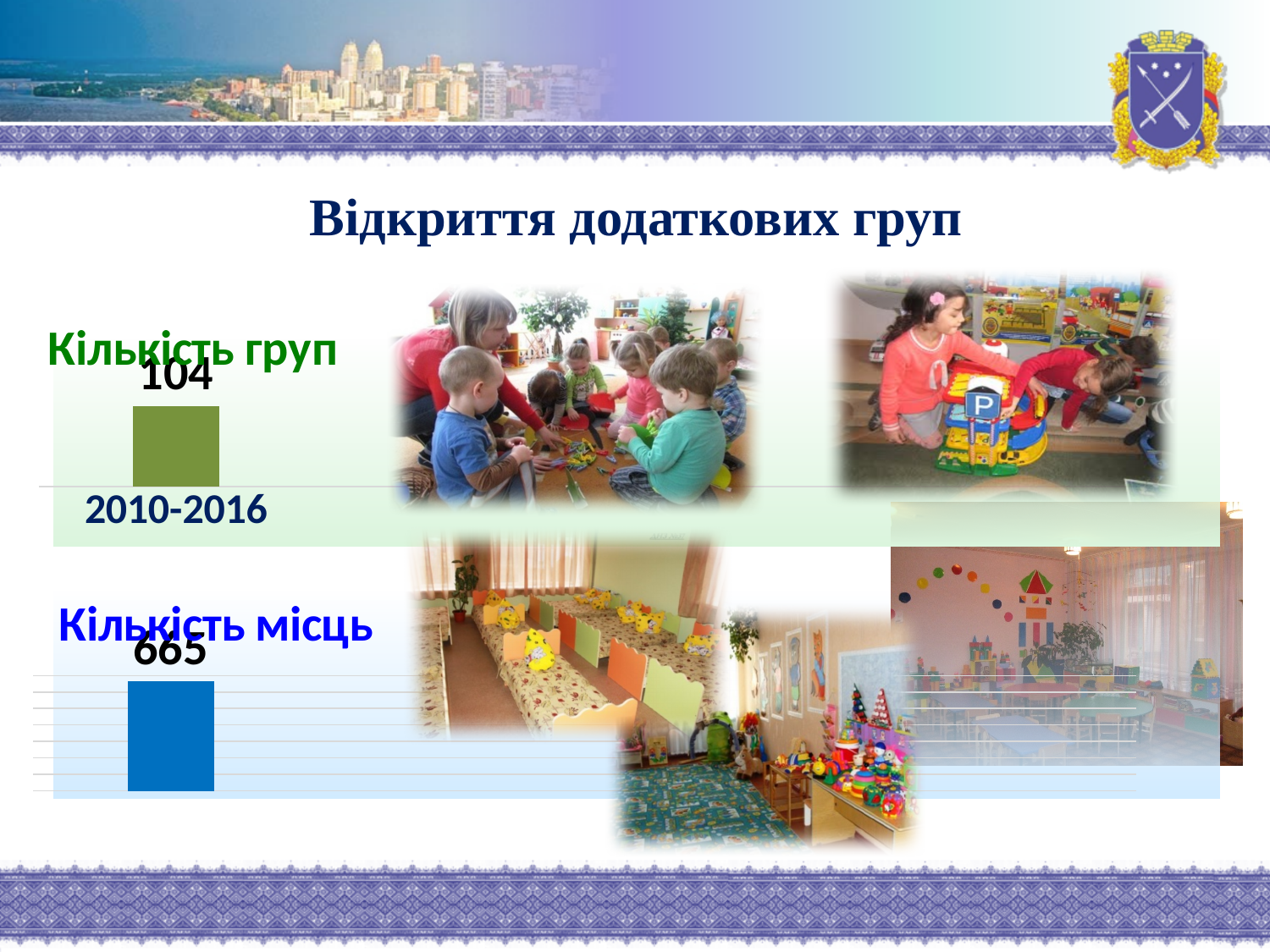
On the 'Кількість місць' chart, what value is printed on the bar? 665 How many bars does the 'Кількість груп' chart show? 1 What category label appears under the bar on the 'Кількість груп' chart? 2010-2016 Which is larger: the value on the 'Кількість груп' chart or the value on the 'Кількість місць' chart? Кількість місць On the 'Кількість груп' chart, what value is shown for 2010-2016? 104 What is the difference between the value on the 'Кількість місць' chart and the value on the 'Кількість груп' chart? 561 How many bars does the 'Кількість місць' chart show? 1 What colour is the bar on the 'Кількість місць' chart? blue What kind of chart is the 'Кількість місць' chart? bar chart What kind of chart is the 'Кількість груп' chart? bar chart